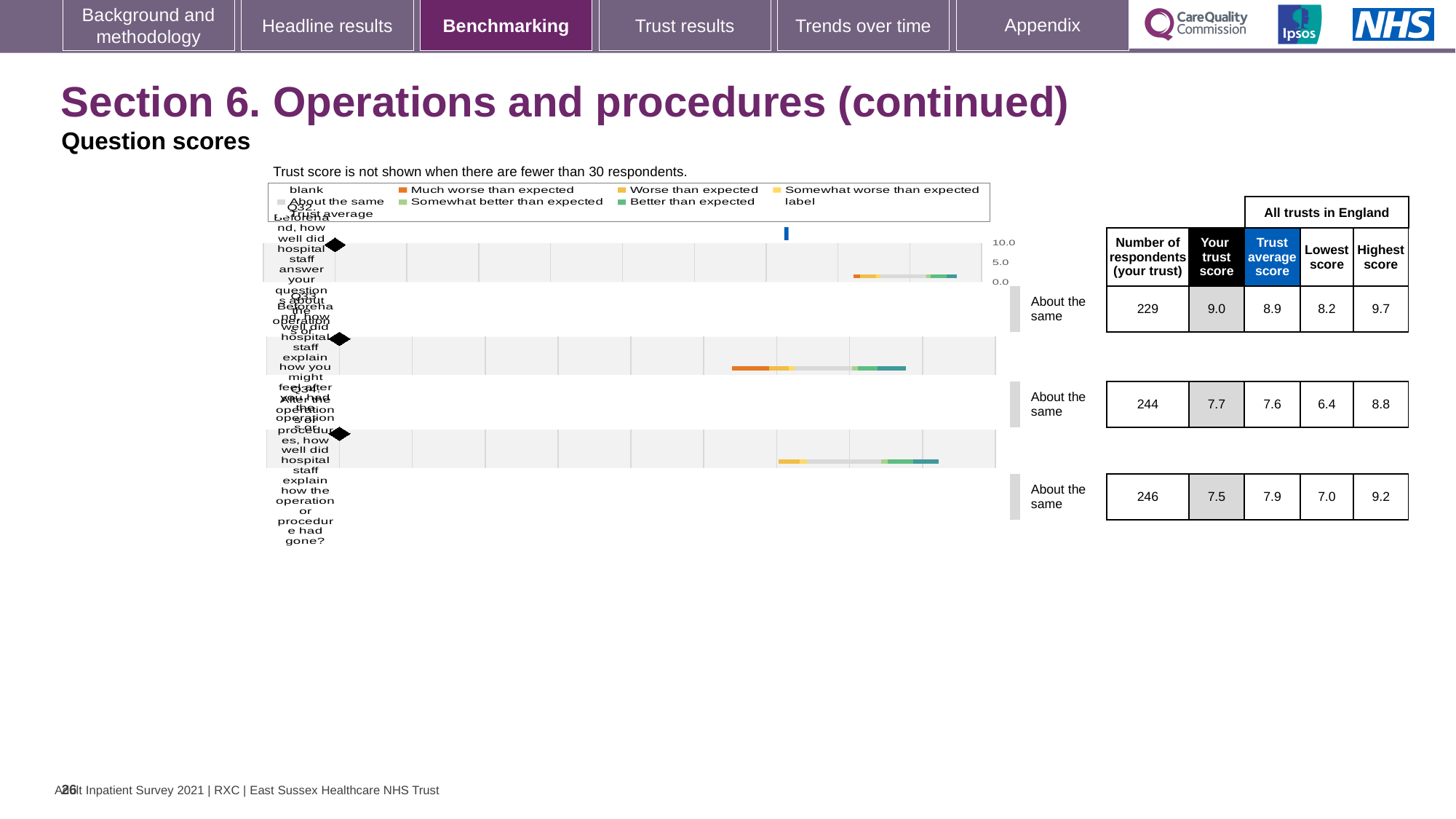
What is the 'Highest score' for the third (bottom) question row? 9.2 For the second (middle) question row, which is larger: 'Your trust score' or 'Trust average score'? Your trust score What is the 'Your trust score' value for the first (top) question row? 9.0 What is the 'Trust average score' for the second (middle) question row? 7.6 What kind of chart is used to show the benchmarking results? Bar chart What is the maximum value shown on the chart's score axis? 10.0 In the table next to the chart, what is the number of respondents for the first (top) question row? 229 How many question rows are shown in the benchmarking chart? 3 What benchmark category label is shown to the right of each of the three question rows? About the same What is the 'Lowest score' for the second (middle) question row? 6.4 For the third (bottom) question row, what is the difference between the 'Trust average score' and 'Your trust score'? 0.4 Which question row has the highest 'Your trust score'? The first (top) row